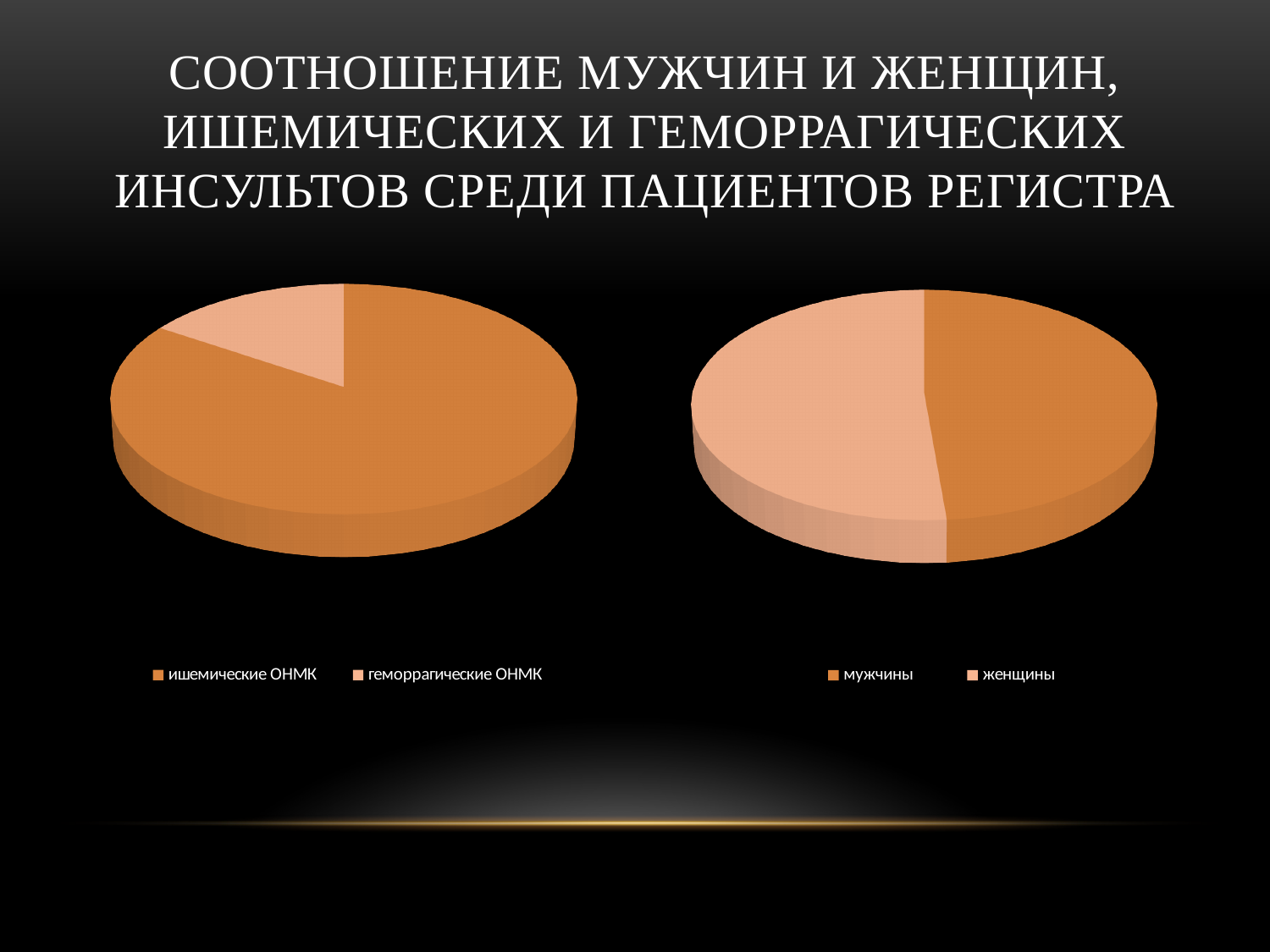
How many entries does the legend of the right pie chart list? 2 What kind of chart is the left chart on the slide? pie chart In the left pie chart, which category has the largest slice? ишемические ОНМК How many slices does the right pie chart have? 2 How many entries does the legend of the left pie chart list? 2 How many charts are shown on the slide? 2 How many slices does the left pie chart have? 2 What kind of chart is the right chart on the slide? pie chart In the left pie chart, which category has the smallest slice? геморрагические ОНМК In the left pie chart, which slice is larger: ишемические ОНМК or геморрагические ОНМК? ишемические ОНМК What are the two legend entries of the right pie chart? мужчины, женщины